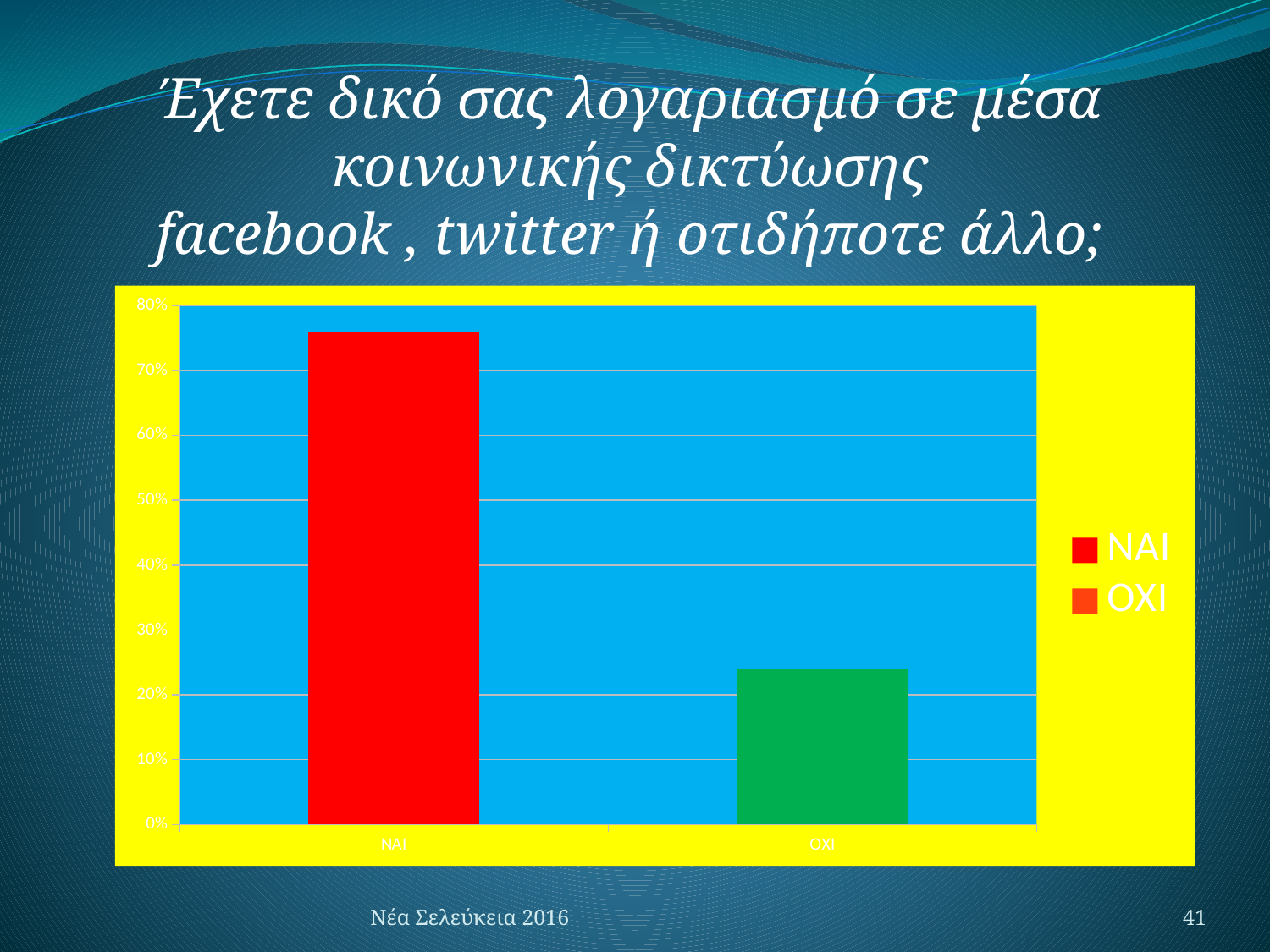
Which is larger, the value for ΝΑΙ or the value for ΟΧΙ? ΝΑΙ Is the value for ΝΑΙ greater or less than 70%? greater Is the value for ΝΑΙ greater or less than 80%? less What colour is the bar for ΝΑΙ in the chart? red Which category has the lowest bar in the chart? ΟΧΙ What are the two entries listed in the chart's legend? ΝΑΙ and ΟΧΙ How many entries does the chart's legend list? 2 Is the value for ΟΧΙ greater or less than 30%? less What kind of chart is shown on the slide? bar chart Which category has the highest bar in the chart? ΝΑΙ How many categories are shown on the x axis of the chart? 2